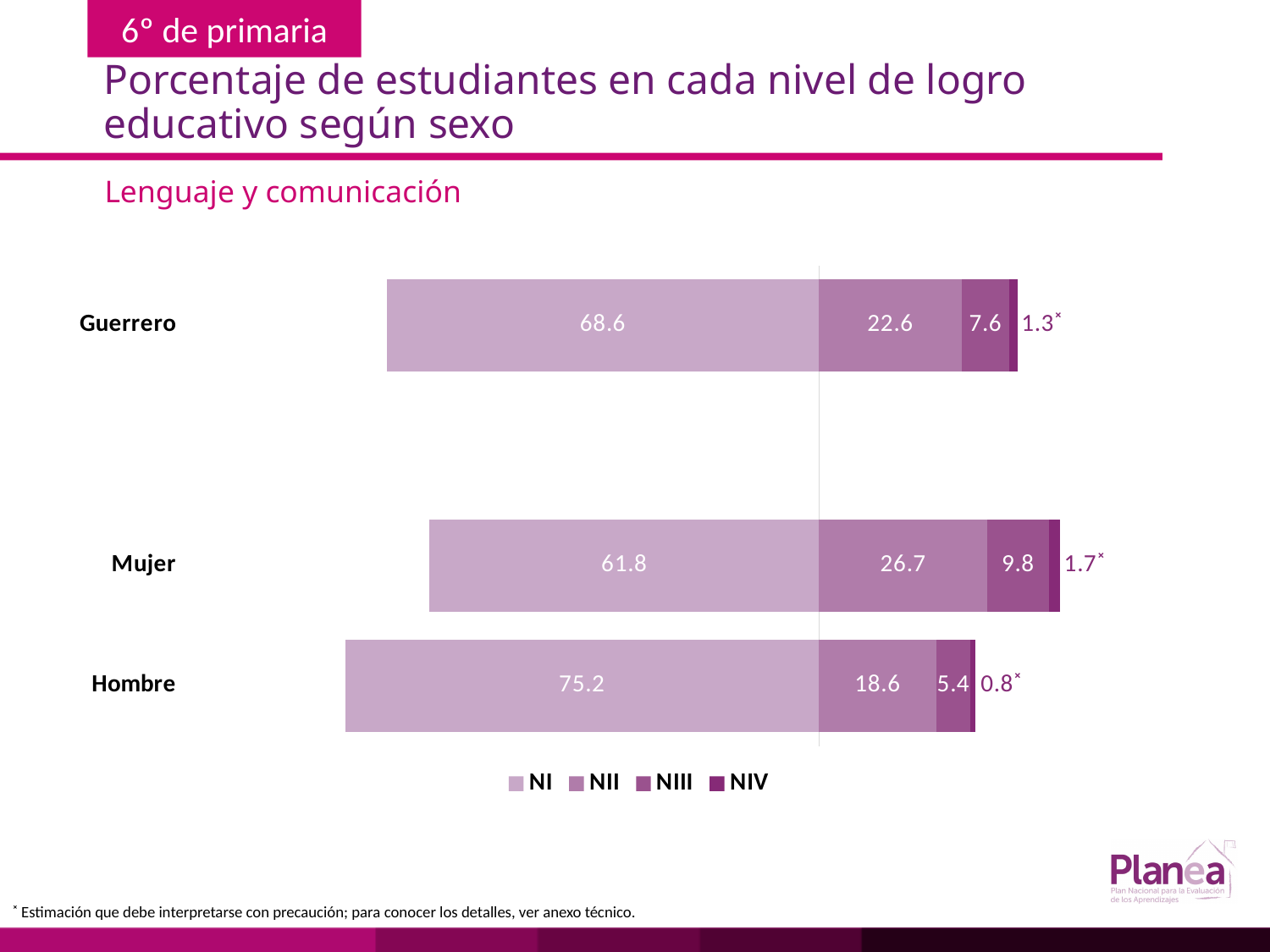
What is the difference between the NI values for Hombre and Mujer? 13.4 How many series does the legend list? 4 What is the NI value for Guerrero? 68.6 How many categories are shown in the chart? 3 What is the NII value for Mujer? 26.7 Which category has the lowest NIII value? Hombre What is the subtitle shown above the chart? Lenguaje y comunicación Which category has the highest NI value? Hombre What type of chart is shown on the slide? stacked bar chart Which is larger, the NII value for Mujer or the NII value for Hombre? Mujer What is the NIII value for Guerrero? 7.6 What is the NI value for Hombre? 75.2